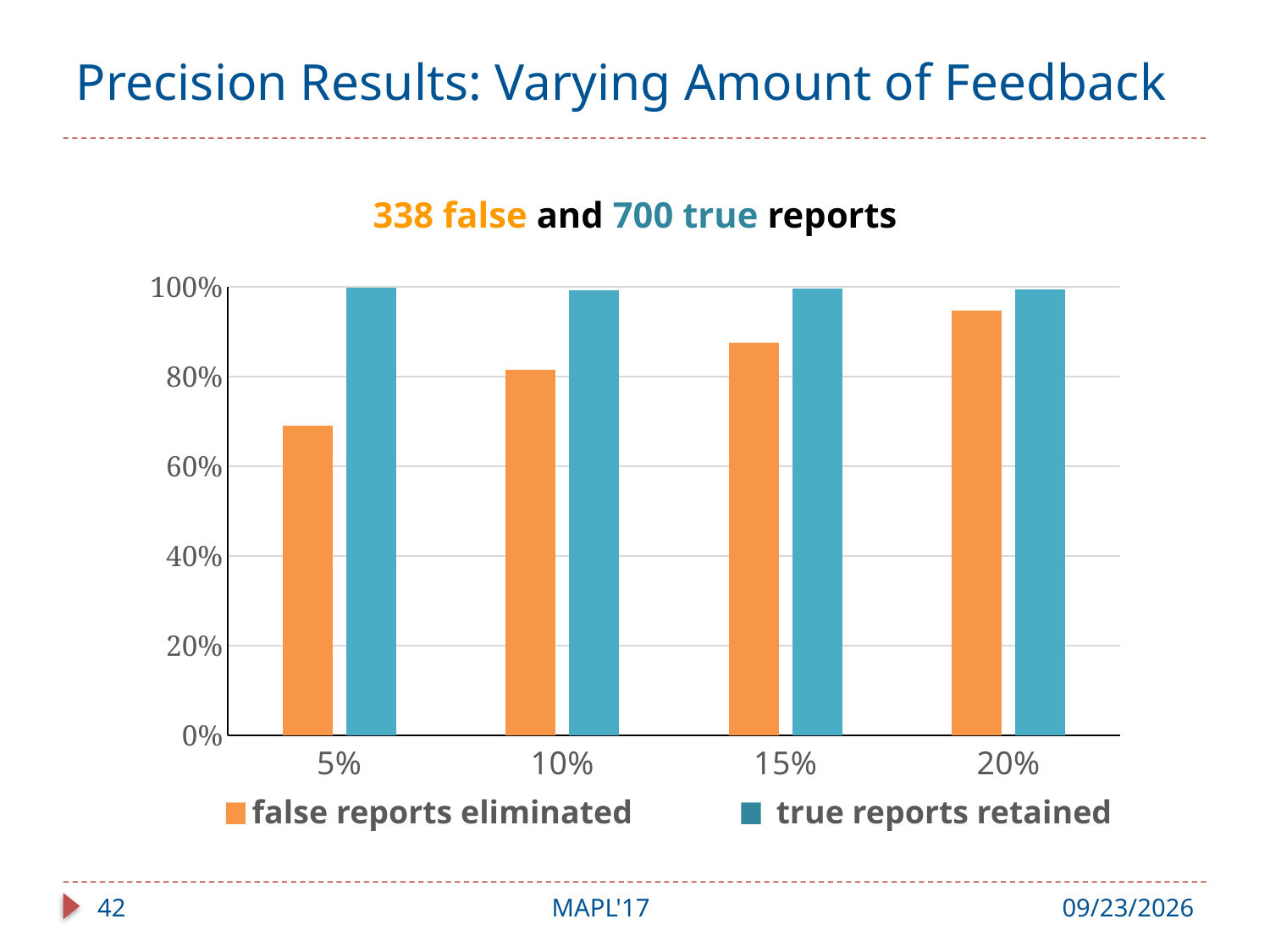
What is the title of the chart? 338 false and 700 true reports How many categories are shown on the x axis? 4 Do the values for false reports eliminated rise or fall as the feedback amount increases from 5% to 20%? rise At 5% feedback, which is larger: false reports eliminated or true reports retained? true reports retained Which series is shown in orange? false reports eliminated How many series does the legend list? 2 What kind of chart is shown on the slide? bar chart Is the value for false reports eliminated at 5% greater or less than 80%? less At which feedback amount is the value for false reports eliminated lowest? 5% At which feedback amount is the value for false reports eliminated highest? 20% Is the value for true reports retained at 15% greater or less than 80%? greater